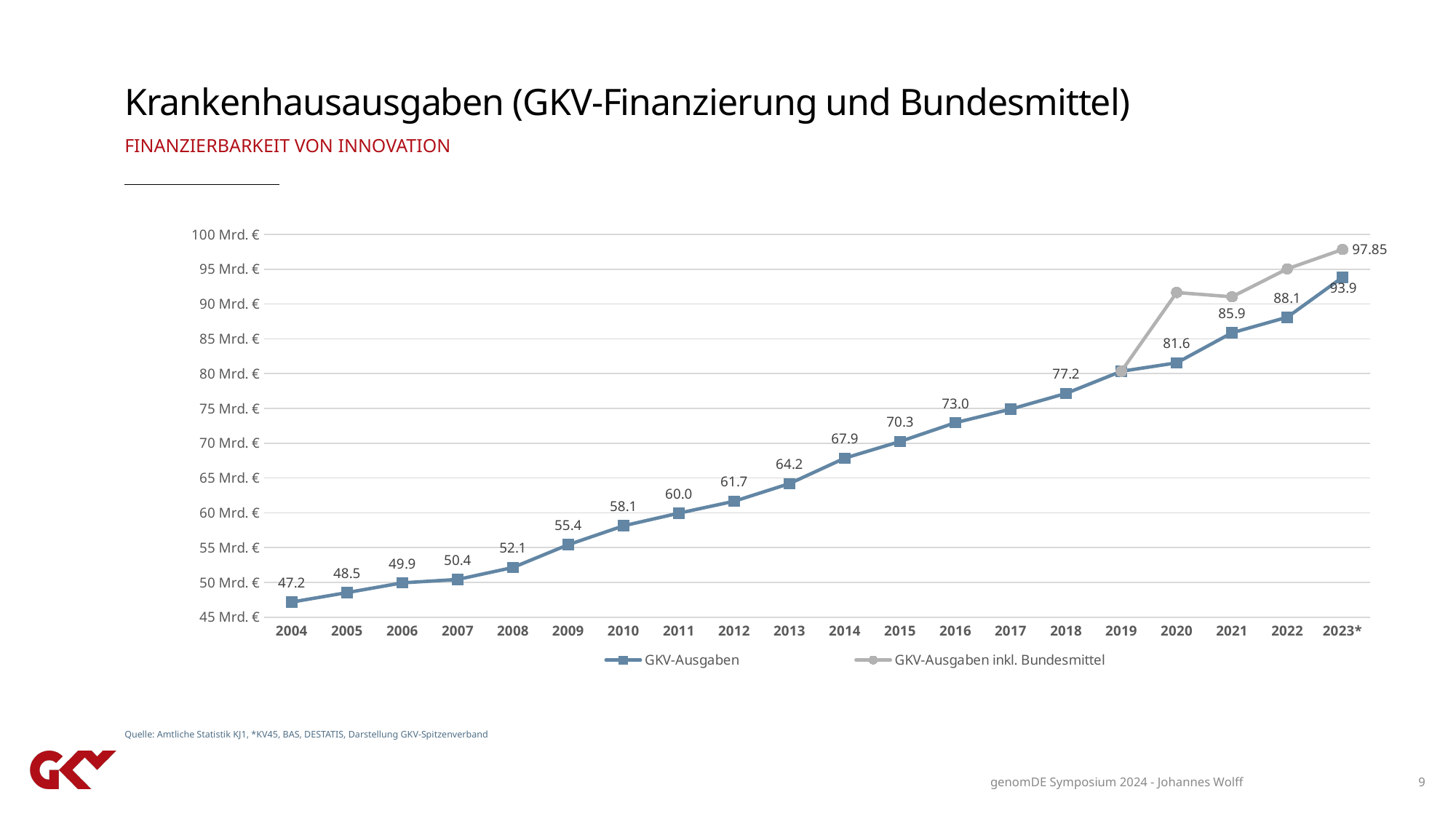
What is the value of GKV-Ausgaben for 2004? 47.2 What is the difference between the GKV-Ausgaben values for 2023* and 2004? 46.7 What is the difference between the GKV-Ausgaben values for 2022 and 2021? 2.2 How many years are shown on the x axis? 20 Is the value of GKV-Ausgaben inkl. Bundesmittel for 2020 greater or less than 90 Mrd. €? greater In 2020, which series has the larger value: GKV-Ausgaben or GKV-Ausgaben inkl. Bundesmittel? GKV-Ausgaben inkl. Bundesmittel What kind of chart is shown on the slide? line chart Do the GKV-Ausgaben values rise or fall from 2004 to 2023*? rise How many series does the legend list? 2 What is the value of GKV-Ausgaben for 2014? 67.9 In which year is GKV-Ausgaben lowest? 2004 What is the value of GKV-Ausgaben inkl. Bundesmittel for 2023*? 97.85